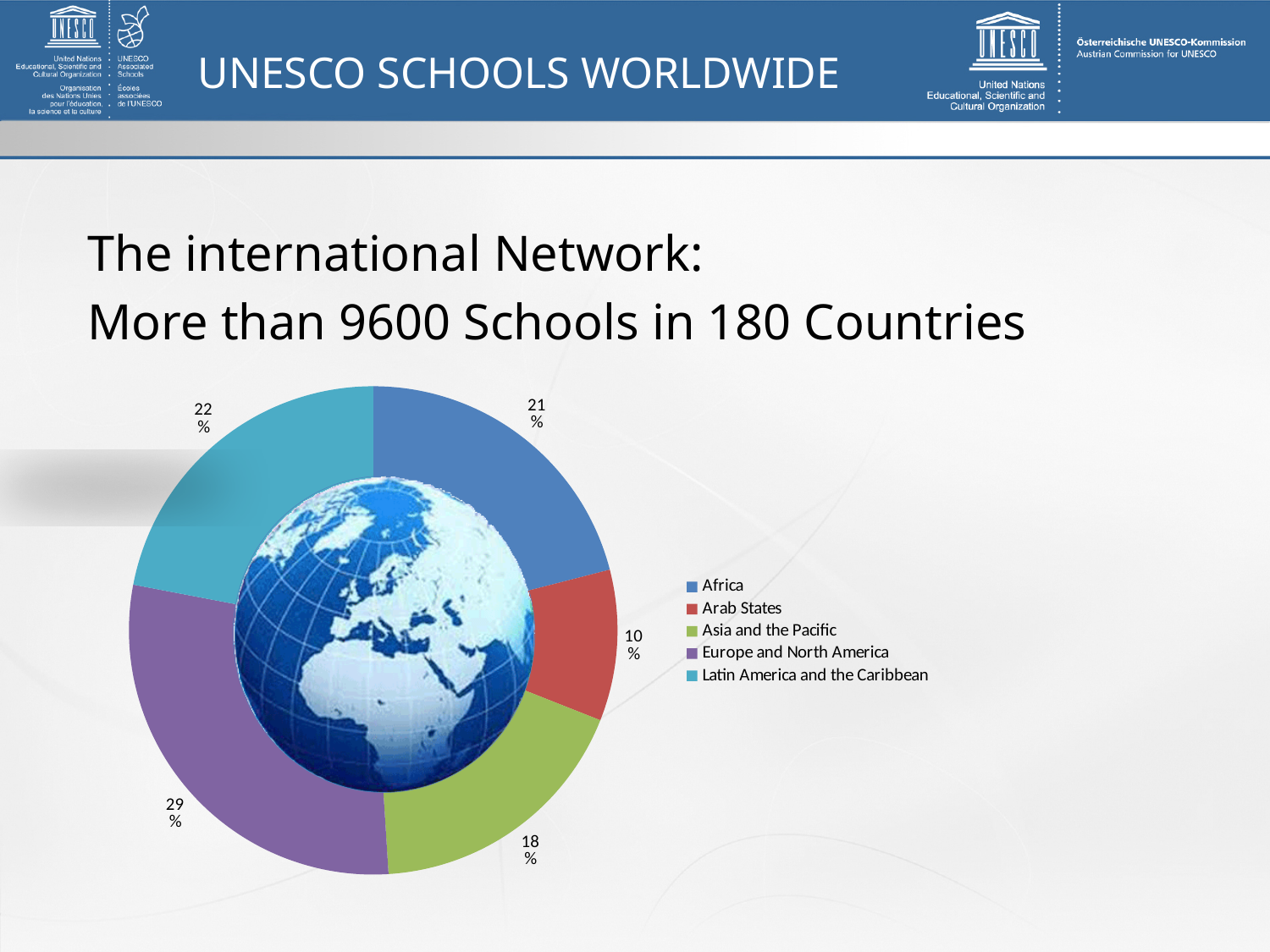
How many regions are shown in the chart? 5 What colour represents Europe and North America in the chart? Purple What share of UNESCO schools is in Europe and North America? 29% What share of UNESCO schools is in Latin America and the Caribbean? 22% What share of UNESCO schools is in the Arab States? 10% What share of UNESCO schools is in Africa? 21% What kind of chart is shown on the slide? Pie chart How many percentage points larger is the share for Europe and North America than for Asia and the Pacific? 11 Which region has the smallest share of UNESCO schools? Arab States Which has a larger share, Africa or Latin America and the Caribbean? Latin America and the Caribbean What share of UNESCO schools is in Asia and the Pacific? 18% Which region has the largest share of UNESCO schools? Europe and North America